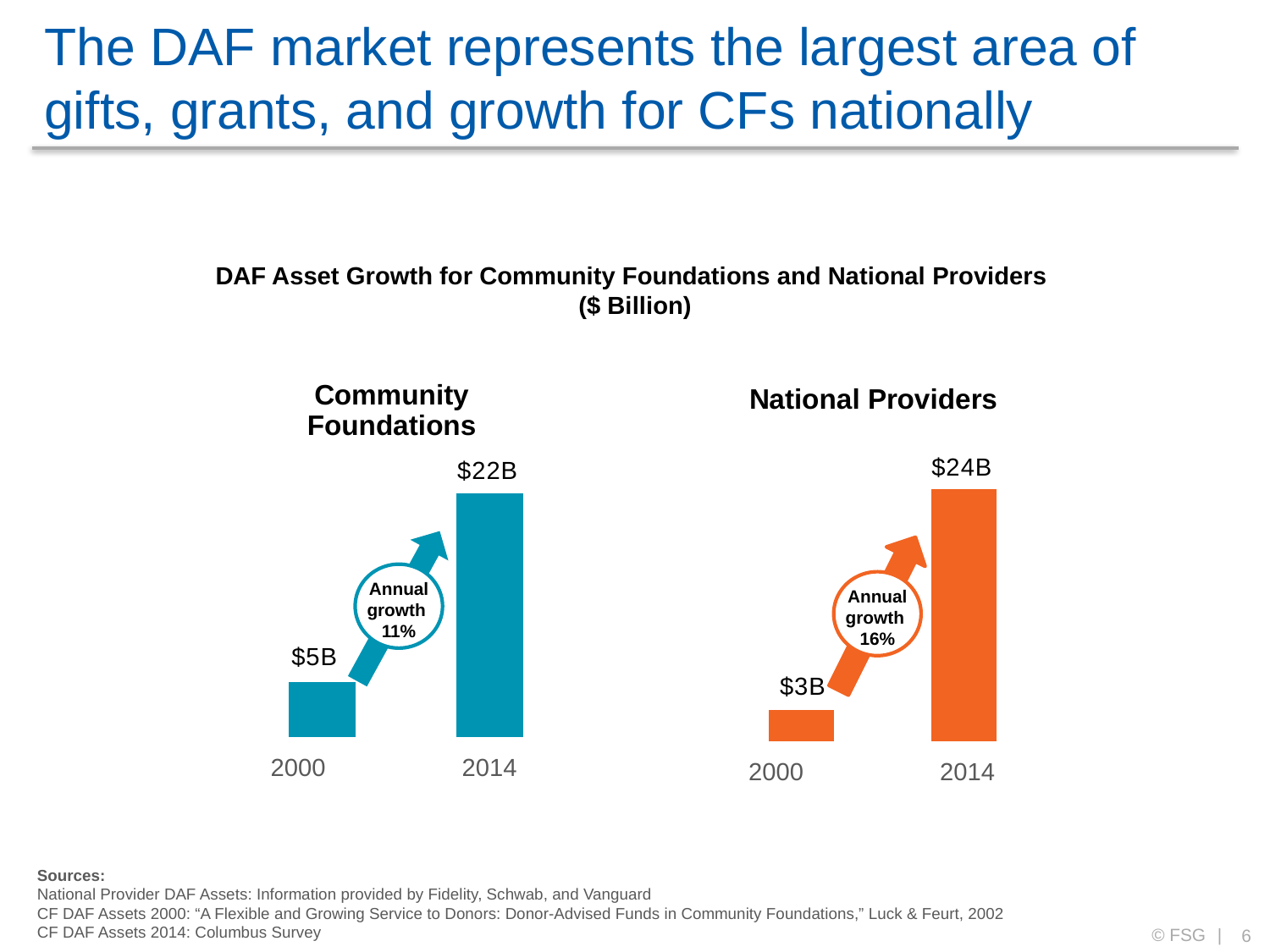
In the National Providers chart, which year has the higher value? 2014 In the National Providers chart, what is the difference between the 2014 and 2000 values? $21B In the Community Foundations chart, how many bars are plotted? 2 In the Community Foundations chart, what is the difference between the 2014 and 2000 values? $17B In the National Providers chart, what is the value for 2014? $24B In the Community Foundations chart, what is the value for 2014? $22B In the Community Foundations chart, which year has the lower value? 2000 Which is larger: the 2014 value for Community Foundations or the 2014 value for National Providers? National Providers In the National Providers chart, what is the value for 2000? $3B What kind of chart is the National Providers chart? Bar chart In the Community Foundations chart, what is the value for 2000? $5B What annual growth rate is shown on the National Providers chart? 16%